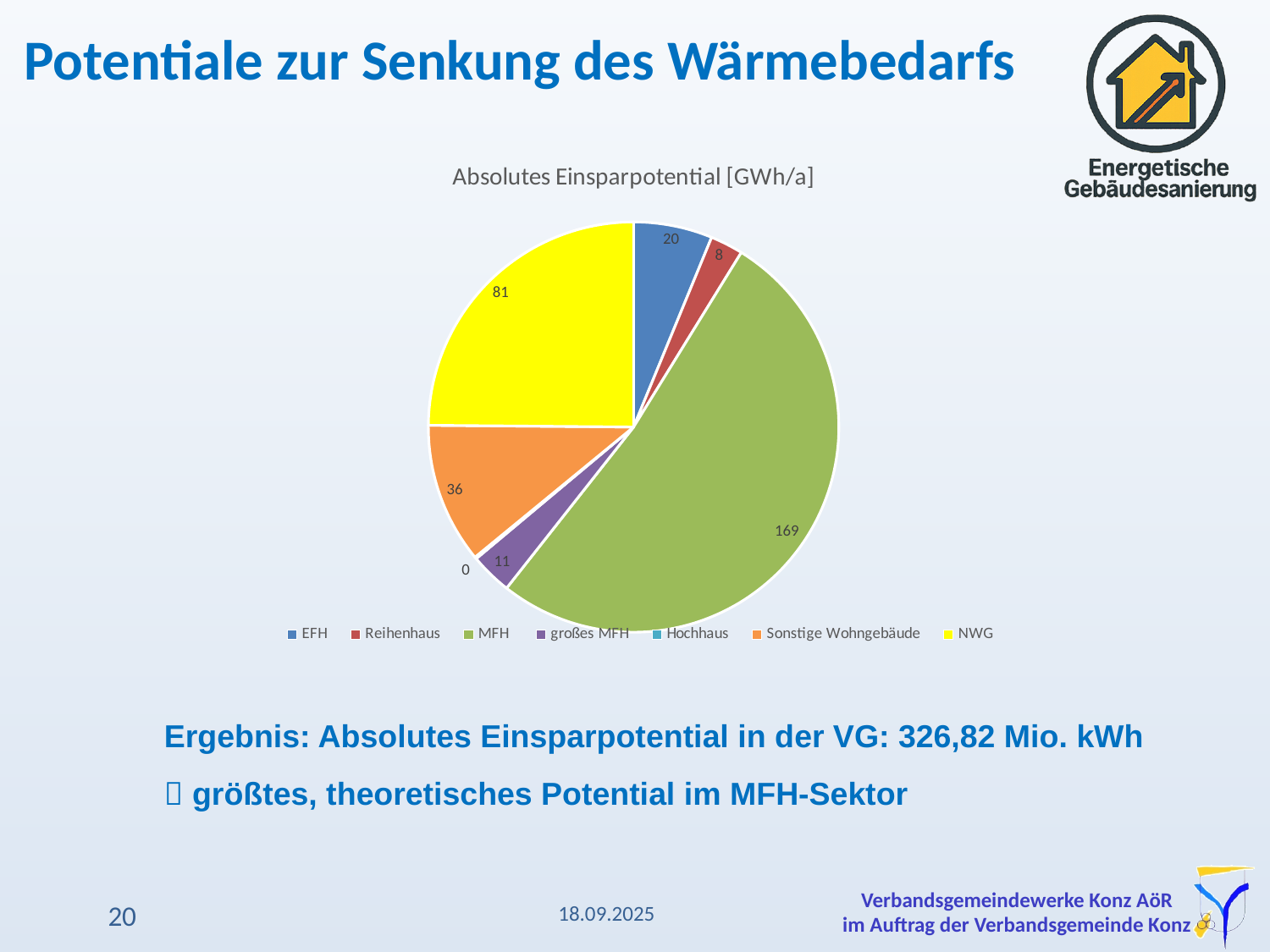
Which category has the smallest slice in the pie chart? Hochhaus What type of chart is shown on the slide? pie chart What is the value for Hochhaus in the pie chart? 0 What is the value for Sonstige Wohngebäude in the pie chart? 36 What is the value for NWG in the pie chart? 81 Which category has the largest slice in the pie chart? MFH How many categories does the legend of the pie chart list? 7 What is the title of the chart? Absolutes Einsparpotential [GWh/a] What share of the pie does the MFH slice represent? 52% Which is larger, the value for EFH or the value for Reihenhaus? EFH What is the value for MFH in the pie chart? 169 What is the difference between the values for MFH and NWG? 88